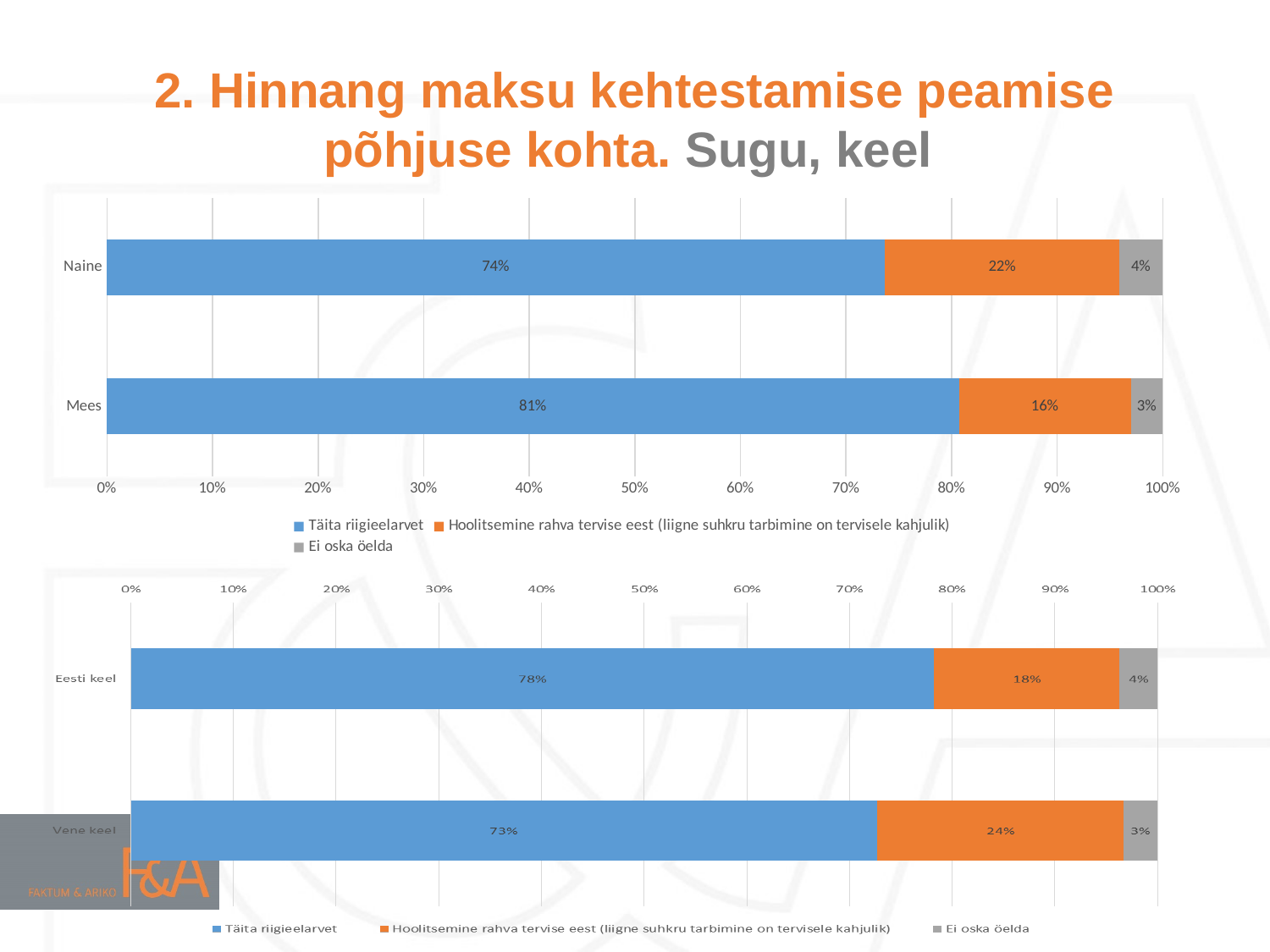
In the top chart (Naine/Mees), what is the value of 'Täita riigieelarvet' for Naine? 74% In the top chart (Naine/Mees), what is the value of 'Hoolitsemine rahva tervise eest' for Mees? 16% In the bottom chart (Eesti keel/Vene keel), what is the value of 'Hoolitsemine rahva tervise eest' for Eesti keel? 18% What type of chart is the top chart (Naine/Mees)? Stacked bar chart In the bottom chart (Eesti keel/Vene keel), which category has the higher value for 'Hoolitsemine rahva tervise eest'? Vene keel In the bottom chart (Eesti keel/Vene keel), what is the value of 'Täita riigieelarvet' for Vene keel? 73% In the bottom chart (Eesti keel/Vene keel), how many categories are shown? 2 In the top chart (Naine/Mees), what is the value of 'Ei oska öelda' for Naine? 4% In the top chart (Naine/Mees), which category has the higher value for 'Täita riigieelarvet'? Mees In the bottom chart (Eesti keel/Vene keel), what is the total of the stacked bar for Vene keel? 100% In the top chart (Naine/Mees), how many series does the legend list? 3 In the top chart (Naine/Mees), what is the difference between the 'Täita riigieelarvet' values for Mees and Naine? 7%